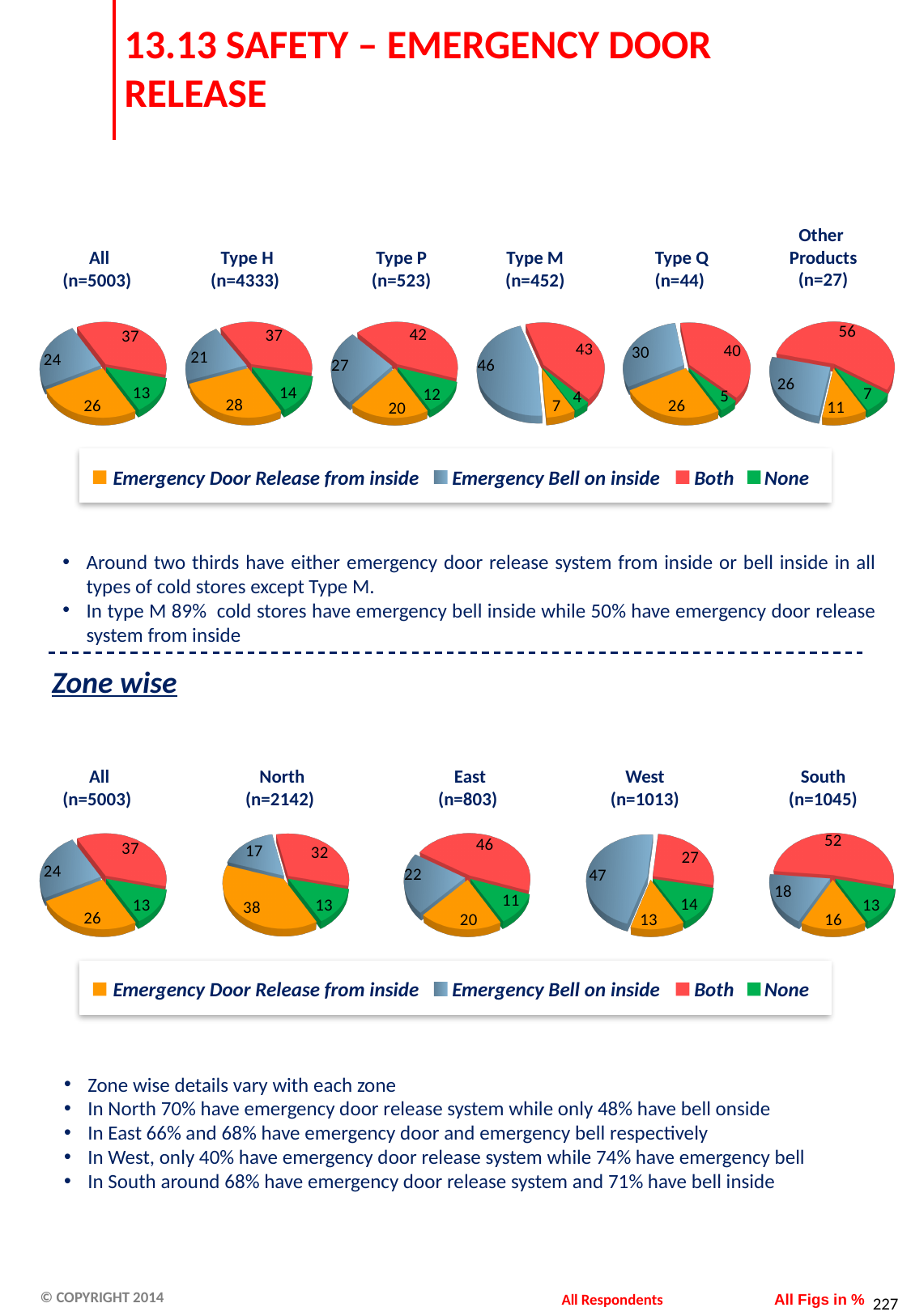
In the Type Q (n=44) pie chart, which category has the smallest slice? None In the legend, which colour represents Both? Red In the Zone wise South (n=1045) pie chart, what is the difference between the Both slice and the Emergency Bell on inside slice? 34 In the Zone wise East (n=803) pie chart, what is the value for None? 11 In the Type P (n=523) pie chart, which is larger: Emergency Bell on inside or Emergency Door Release from inside? Emergency Bell on inside How many pie charts are shown in the Zone wise section of the slide? 5 In the Other Products (n=27) pie chart, what is the value for Both? 56 How many series does the legend below the top row of pie charts list? 4 In the Type M (n=452) pie chart, what is the value for Emergency Bell on inside? 46 In the Zone wise North (n=2142) pie chart, what is the value for Emergency Door Release from inside? 38 In the Zone wise West (n=1013) pie chart, which category has the largest slice? Emergency Bell on inside What type of chart is used for the All (n=5003) data? Pie chart